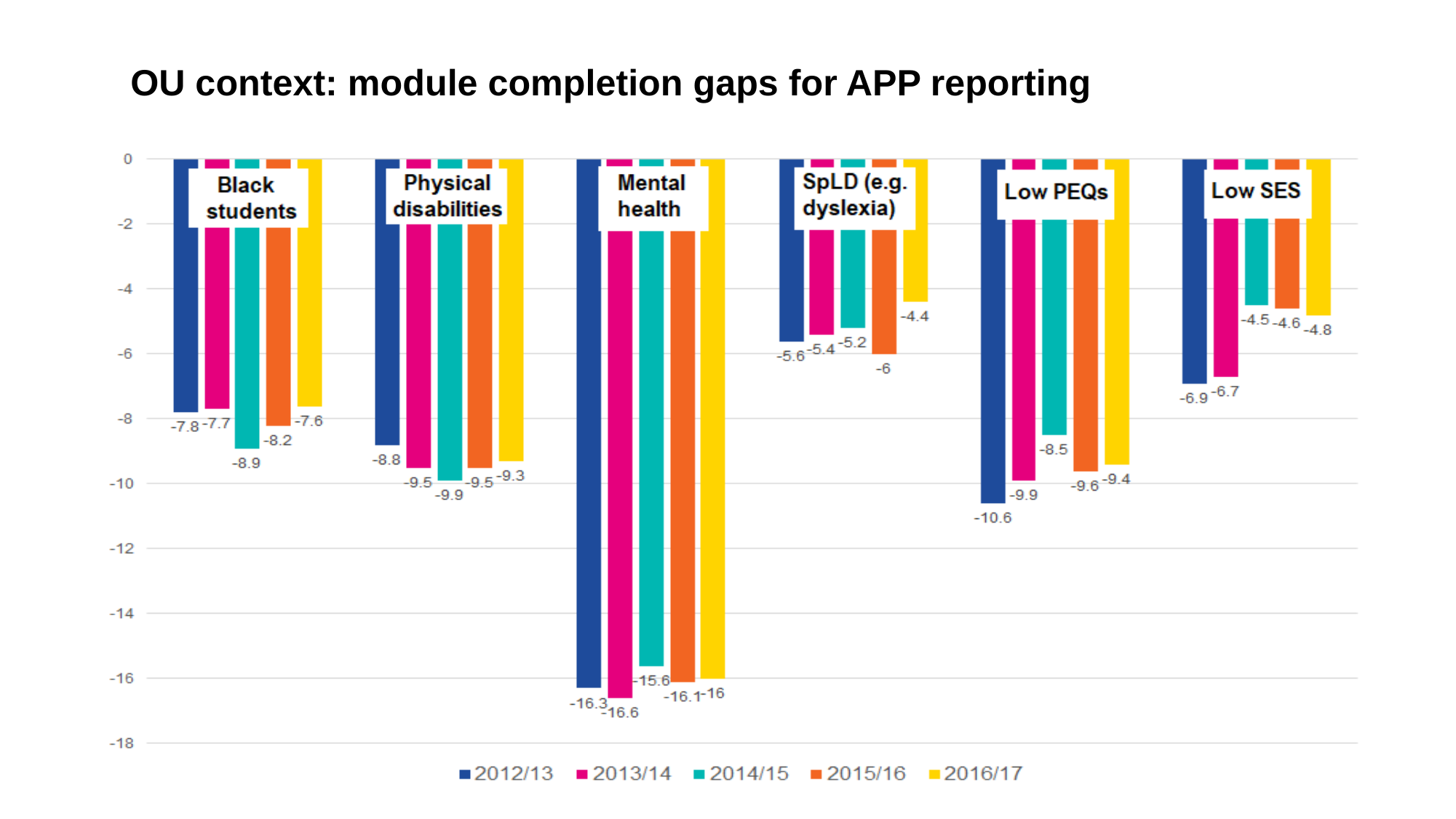
How many categories are shown on the x axis? 6 Which category has the lowest (most negative) value in 2016/17? Mental health Which category has the highest (least negative) value in 2015/16? Low SES What is the difference between the 2012/13 and 2016/17 values for Low SES? 2.1 Which is larger (less negative): the 2014/15 value for Black students or the 2014/15 value for Physical disabilities? Black students How many series does the legend list? 5 Which colour represents the 2016/17 series in the legend? Yellow What is the value for Mental health in 2013/14? -16.6 What is the value for SpLD (e.g. dyslexia) in 2016/17? -4.4 What is the value for Low PEQs in 2012/13? -10.6 What is the value for Low SES in 2014/15? -4.5 What kind of chart is this? Bar chart